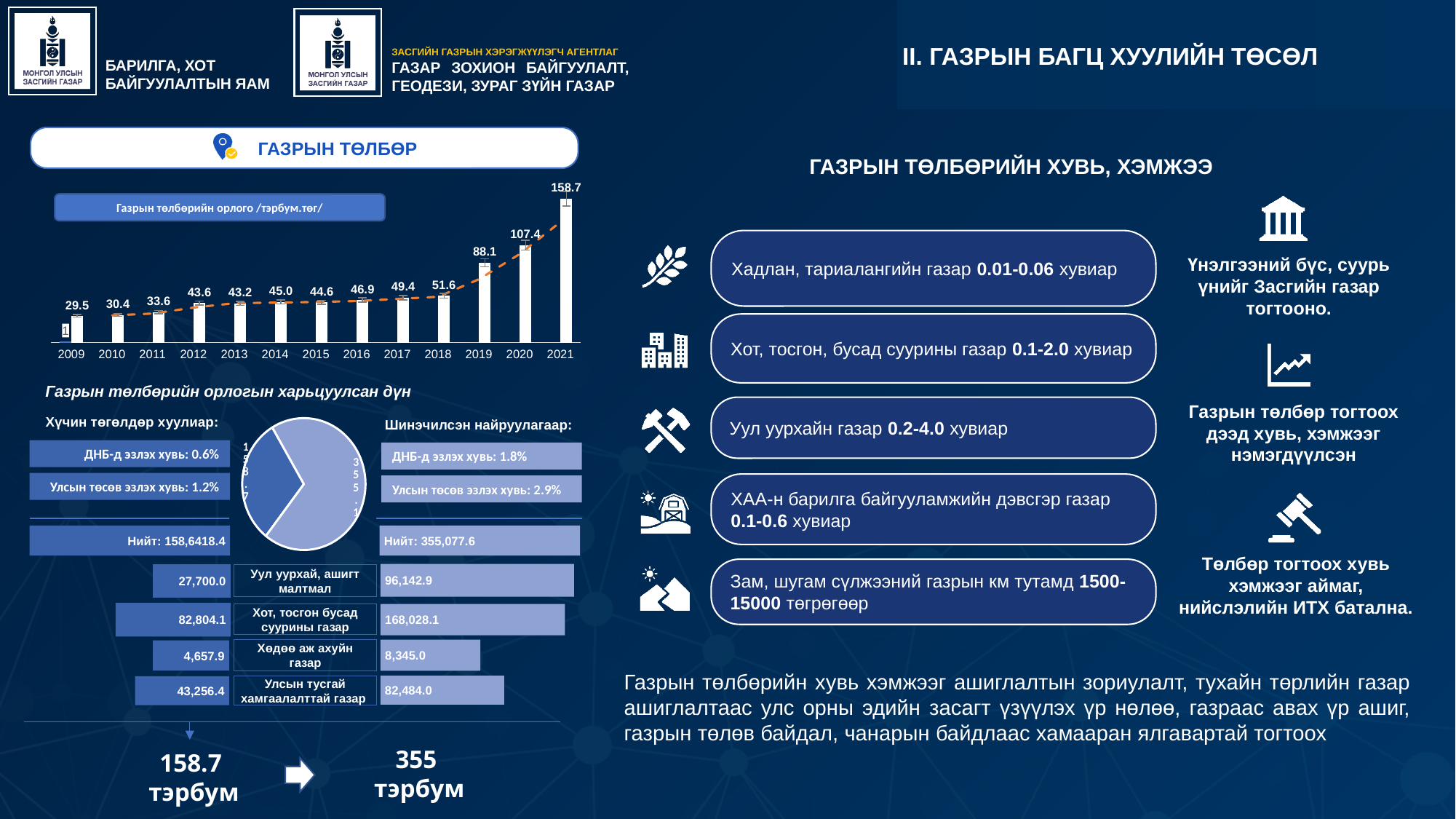
In the bar chart titled 'Газрын төлбөрийн орлого /тэрбум.төг/', what is the value for 2016? 46.9 In the bar chart titled 'Газрын төлбөрийн орлого /тэрбум.төг/', what is the difference between the values for 2021 and 2020? 51.3 In the bar chart titled 'Газрын төлбөрийн орлого /тэрбум.төг/', what is the value for 2021? 158.7 In the bar chart titled 'Газрын төлбөрийн орлого /тэрбум.төг/', do the values generally rise or fall from 2009 to 2021? rise What kind of chart is the chart titled 'Газрын төлбөрийн орлого /тэрбум.төг/'? bar chart In the bar chart titled 'Газрын төлбөрийн орлого /тэрбум.төг/', which year has the lowest value? 2009 In the bar chart titled 'Газрын төлбөрийн орлого /тэрбум.төг/', which year has the highest value? 2021 In the bar chart titled 'Газрын төлбөрийн орлого /тэрбум.төг/', which is larger, the value for 2016 or the value for 2017? 2017 In the bar chart titled 'Газрын төлбөрийн орлого /тэрбум.төг/', what is the difference between the values for 2019 and 2018? 36.5 In the bar chart titled 'Газрын төлбөрийн орлого /тэрбум.төг/', what is the value for 2009? 29.5 In the bar chart titled 'Газрын төлбөрийн орлого /тэрбум.төг/', what is the value for 2019? 88.1 How many years are shown on the x axis of the bar chart titled 'Газрын төлбөрийн орлого /тэрбум.төг/'? 13